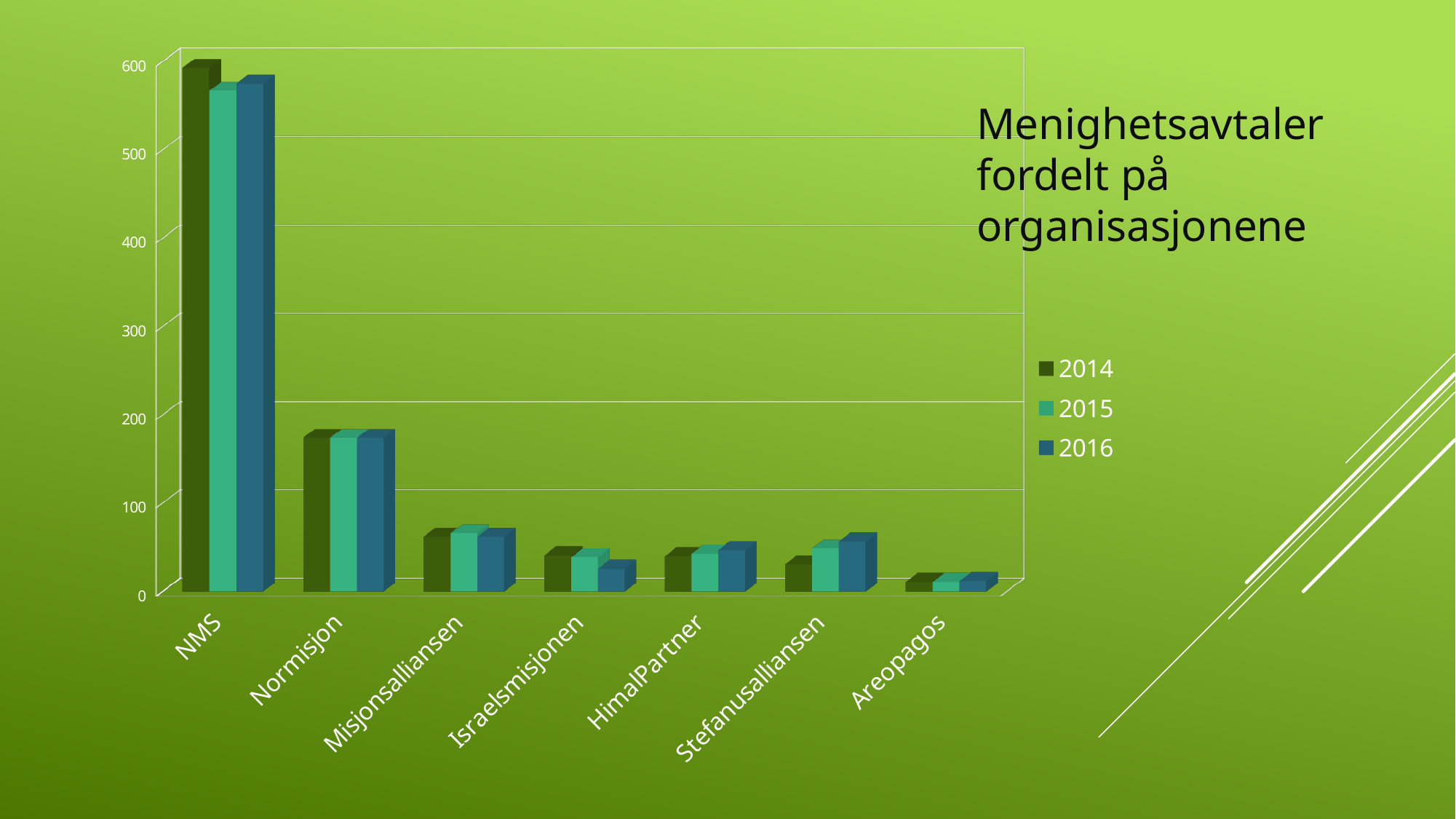
Is the value for NMS in 2014 greater or less than 500? greater Which organisation has the highest value for 2014? NMS Do the values for Stefanusalliansen rise or fall from 2014 to 2016? rise How many organisations are shown on the x axis? 7 Which is larger in 2015: NMS or Normisjon? NMS Is the value for Normisjon in 2016 greater or less than 200? less Which organisation has the lowest value for 2016? Areopagos What kind of chart is shown on the slide? Bar chart Is the value for Misjonsalliansen in 2015 greater or less than 100? less What is the title of the chart? Menighetsavtaler fordelt på organisasjonene How many series does the legend list? 3